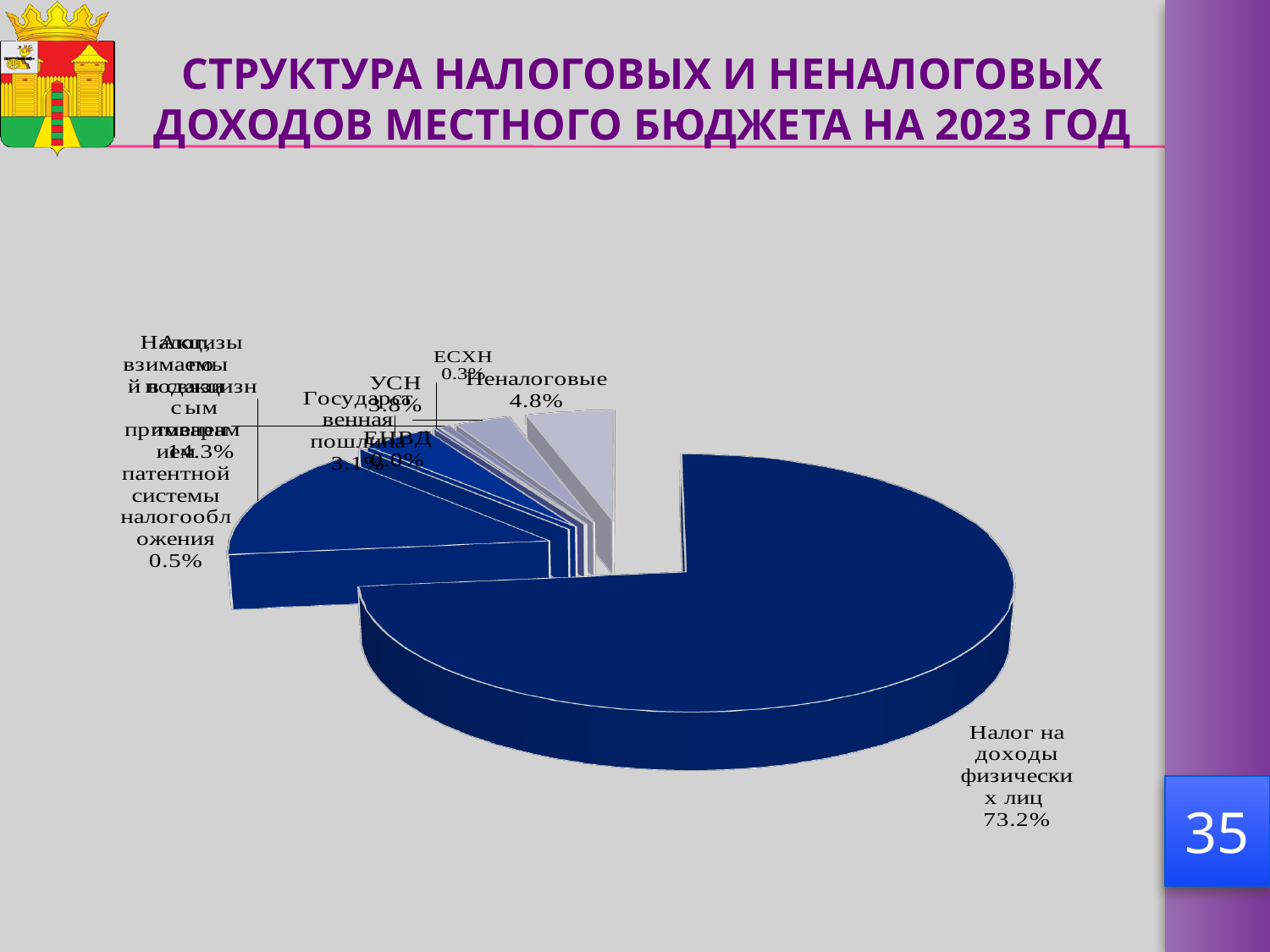
What is the value shown for УСН? 3.8% What is the title of the slide containing the chart? СТРУКТУРА НАЛОГОВЫХ И НЕНАЛОГОВЫХ ДОХОДОВ МЕСТНОГО БЮДЖЕТА НА 2023 ГОД Which category has the largest share of the pie? Налог на доходы физических лиц What is the difference between the shares of Налог на доходы физических лиц and Неналоговые? 68.4% What share of the pie does Налог на доходы физических лиц have? 73.2% What kind of chart is shown on the slide? pie chart What is the value shown for ЕСХН? 0.3% Which is larger, the share for УСН or the share for Государственная пошлина? УСН Which category has the smallest share of the pie? ЕНВД What is the value shown for ЕНВД? 0.0% What is the value shown for Неналоговые? 4.8% What is the value shown for Государственная пошлина? 3.1%